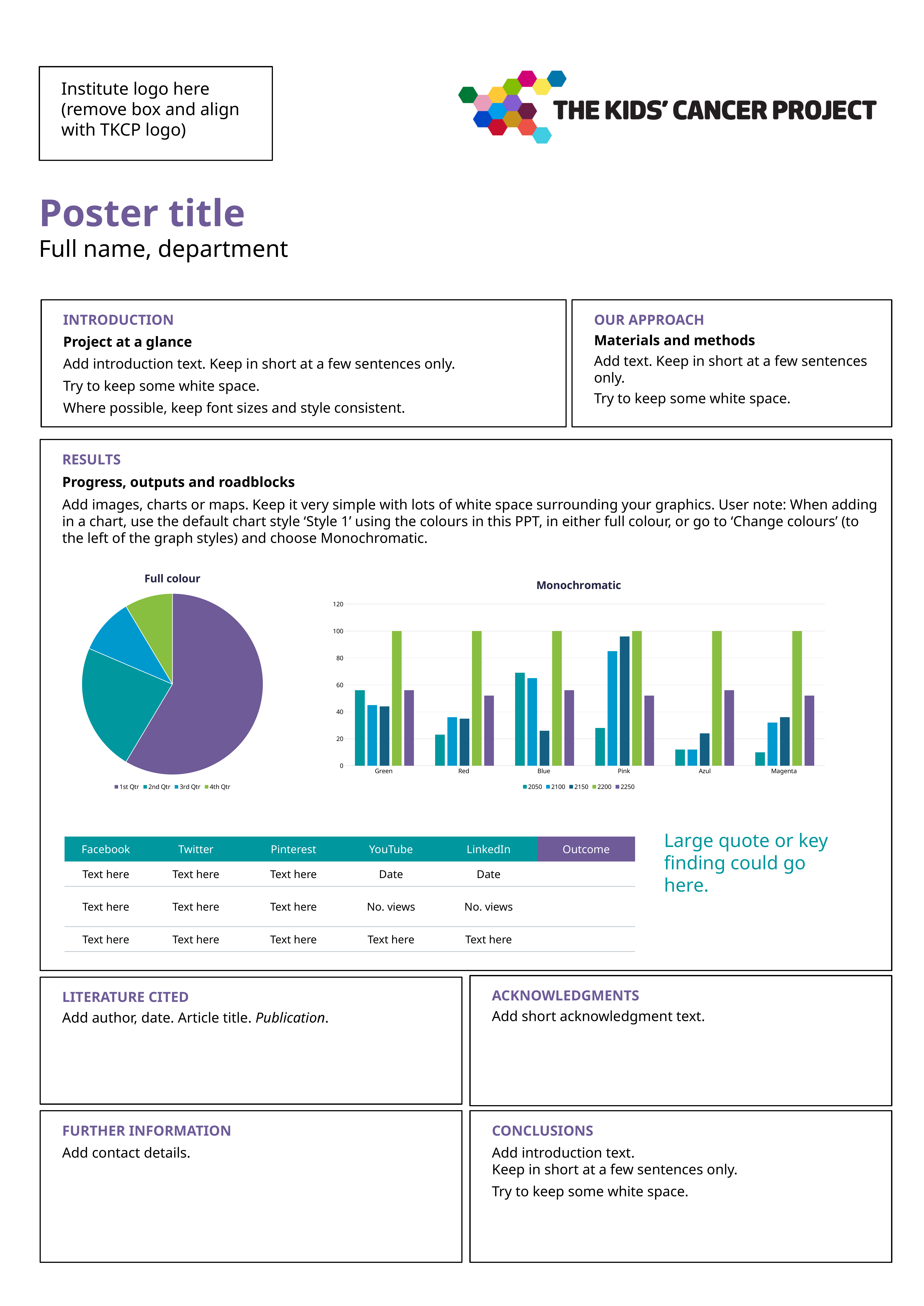
How many slices does the 'Full colour' pie chart have? 4 In the 'Monochromatic' chart, what is the value of the 2200 series for Green? 100 How many series does the legend of the 'Monochromatic' chart list? 5 What kind of chart is the 'Full colour' chart? pie chart In the 'Monochromatic' chart, which is larger for Pink: the 2050 value or the 2100 value? 2100 How many categories are shown on the x axis of the 'Monochromatic' chart? 6 What kind of chart is the 'Monochromatic' chart? bar chart In the 'Monochromatic' chart, which category has the highest 2050 value? Blue In the 'Monochromatic' chart, is the 2100 value for Pink greater or less than 80? greater In the 'Monochromatic' chart, is the 2050 value for Red greater or less than 40? less In the 'Full colour' pie chart, which quarter has the largest slice? 1st Qtr In the 'Monochromatic' chart, which category has the lowest 2100 value? Azul